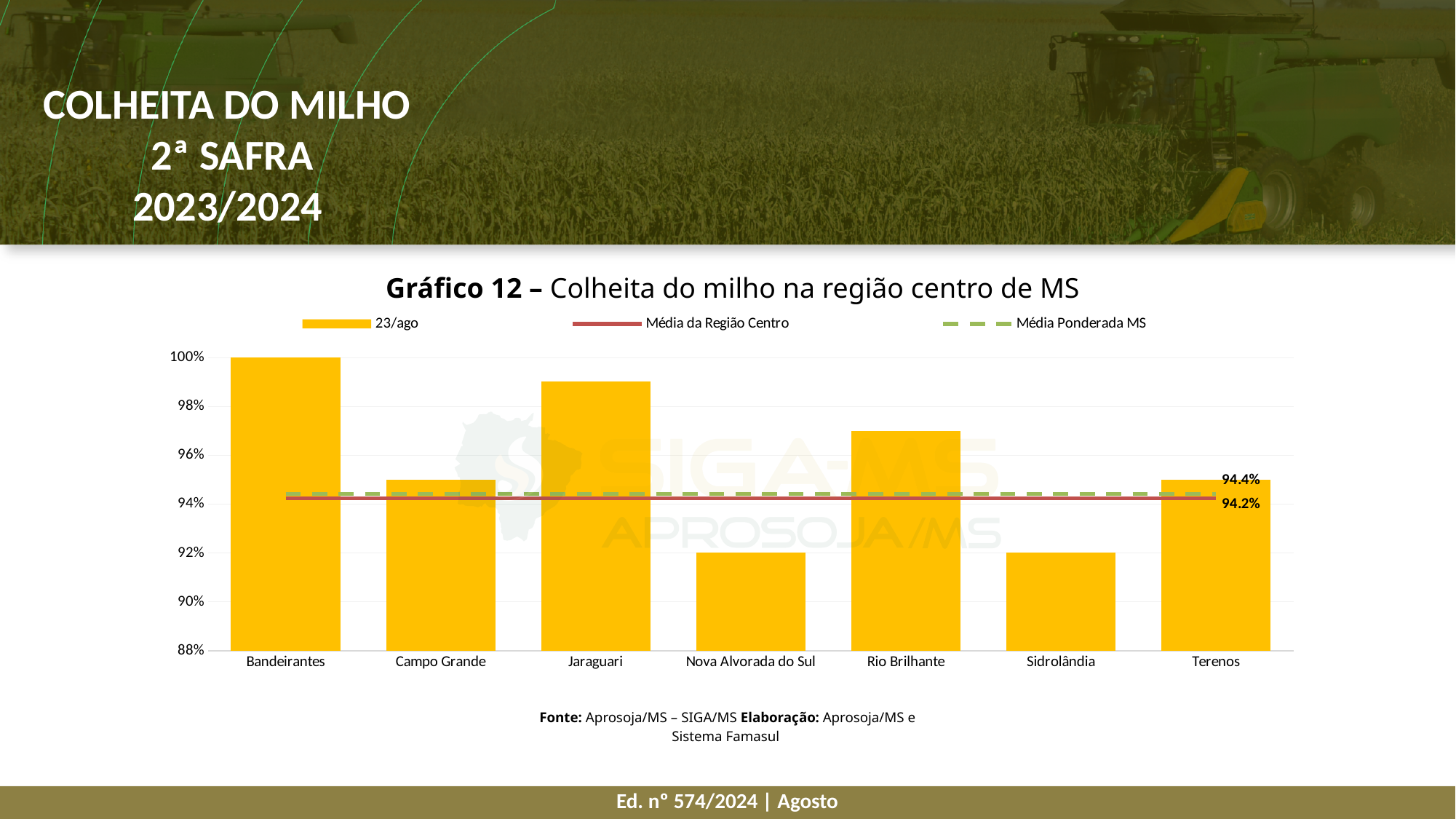
Which municipality has the highest value? Bandeirantes Is the value for Jaraguari greater or less than 98%? greater What is the value of the Média Ponderada MS line? 94.4% What is the value for Bandeirantes? 100% What is the difference between the Média Ponderada MS and the Média da Região Centro? 0.2% How many municipalities are shown on the x axis of the chart? 7 Which has a larger value, Jaraguari or Rio Brilhante? Jaraguari What type of chart is shown on the slide? combination bar and line chart What is the value of the Média da Região Centro line? 94.2% What is the title of the chart? Gráfico 12 – Colheita do milho na região centro de MS How many series does the chart legend list? 3 What is the value for Nova Alvorada do Sul? 92%